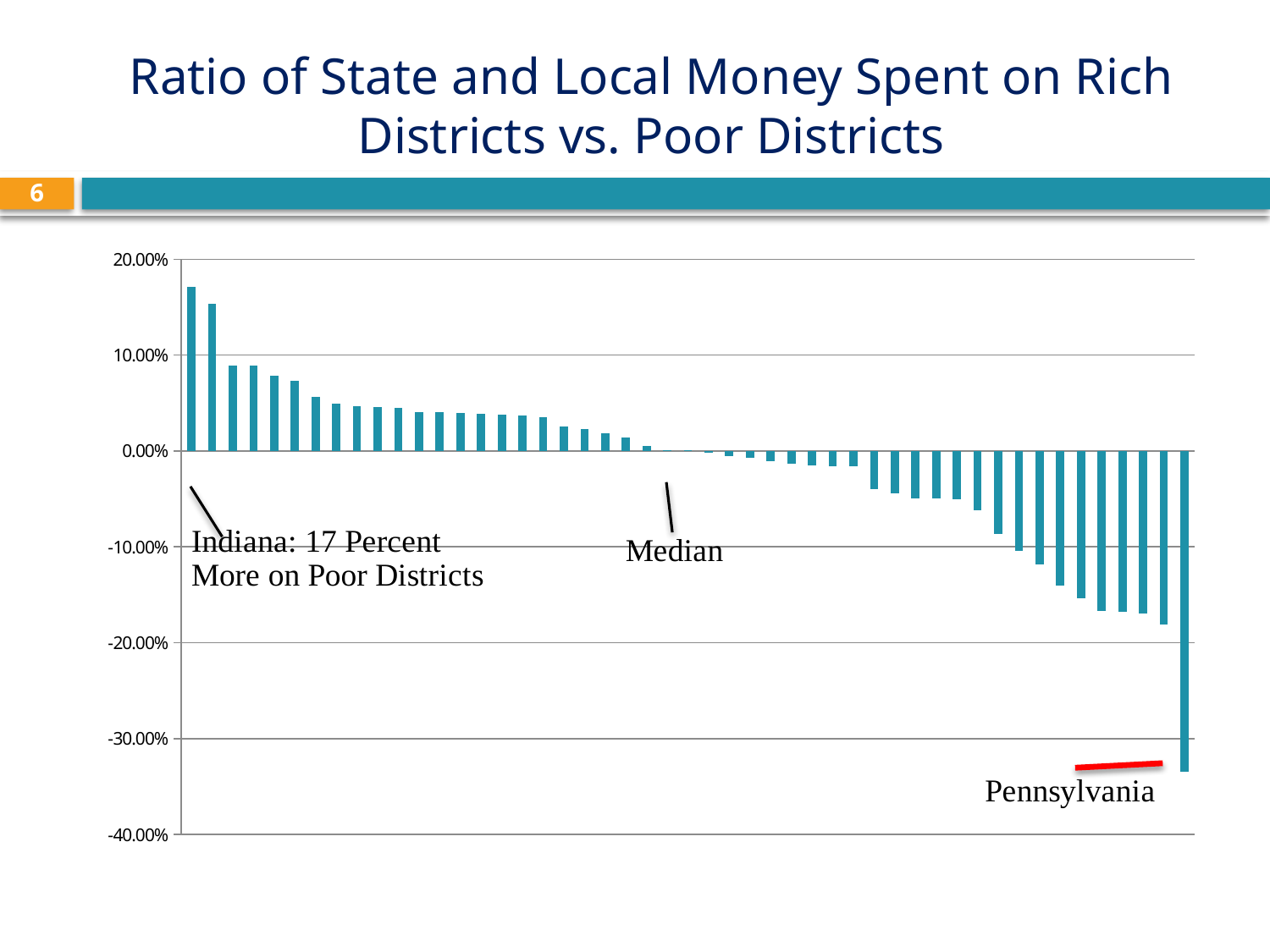
Which has the larger value, Indiana or Pennsylvania? Indiana Is the value for Pennsylvania greater or less than -30.00%? less Do the bar values rise or fall moving from left to right along the x axis? fall Which state is labelled at the highest bar in the chart? Indiana Which state is labelled at the lowest bar in the chart? Pennsylvania What is the title of the chart on the slide? Ratio of State and Local Money Spent on Rich Districts vs. Poor Districts Is the value for Indiana greater or less than 20.00%? less What kind of chart is shown on the slide? bar chart Is the value for Indiana greater or less than 10.00%? greater What is the lowest value shown on the y axis? -40.00% What label is attached to the bar near the middle of the chart where values cross zero? Median According to the annotation, how much more does Indiana spend on poor districts? 17 Percent